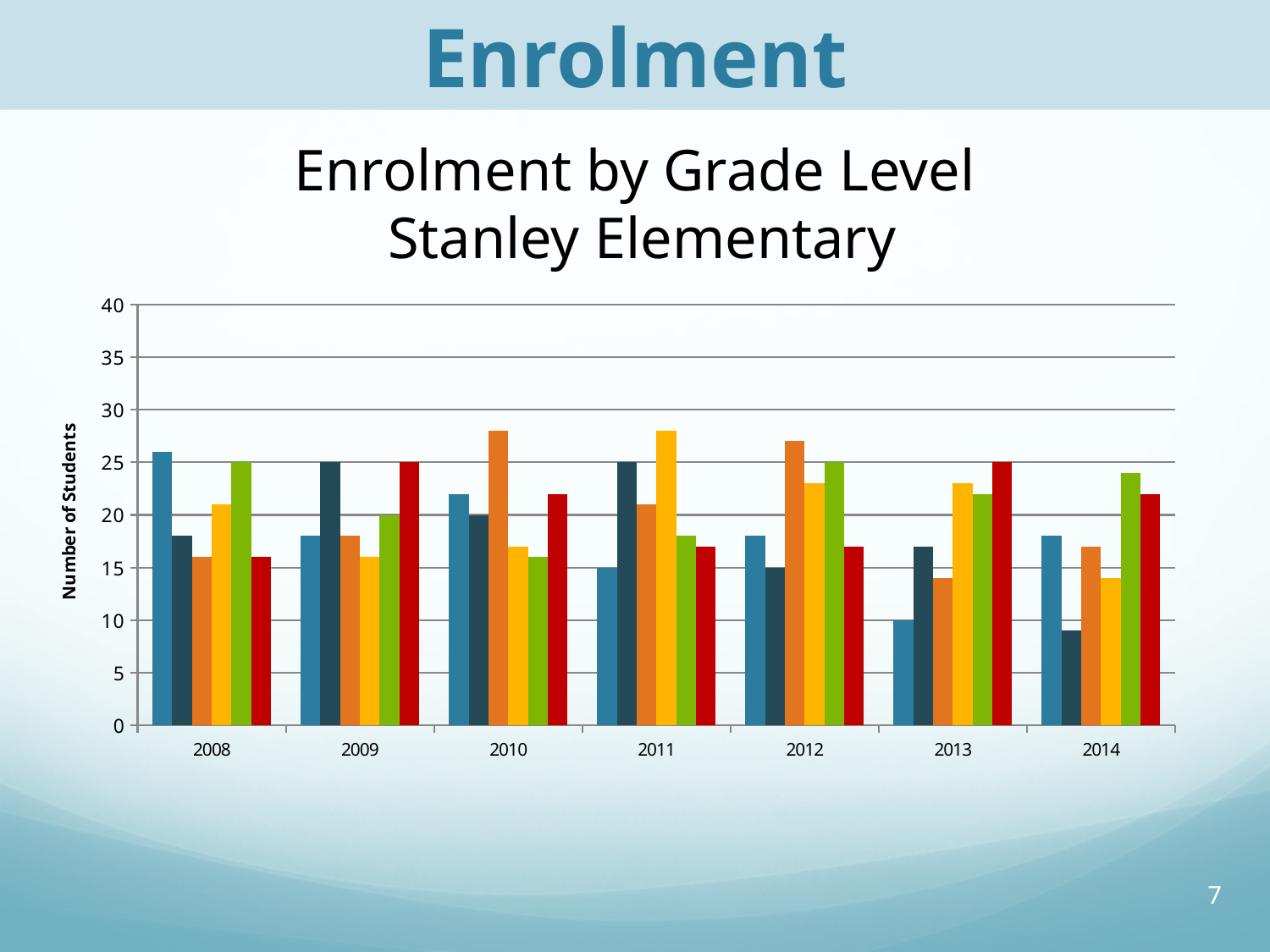
What is the label on the vertical axis of the chart? Number of Students What kind of chart is shown on the slide? bar chart Is the value of the green bar in the 2009 group greater or less than 15? greater Which bar is the tallest in the 2010 group? the orange bar How many years are shown along the x axis of the chart? 7 In the 2008 group, which bar is taller: the light blue bar or the dark blue bar? the light blue bar What is the title of the chart? Enrolment by Grade Level Stanley Elementary Is the value of the dark blue bar in the 2014 group greater or less than 15? less Is the value of the first (light blue) bar in the 2013 group greater or less than 15? less In the 2011 group, which bar is taller: the orange bar or the yellow bar? the yellow bar How many bars are there in each year group of the chart? 6